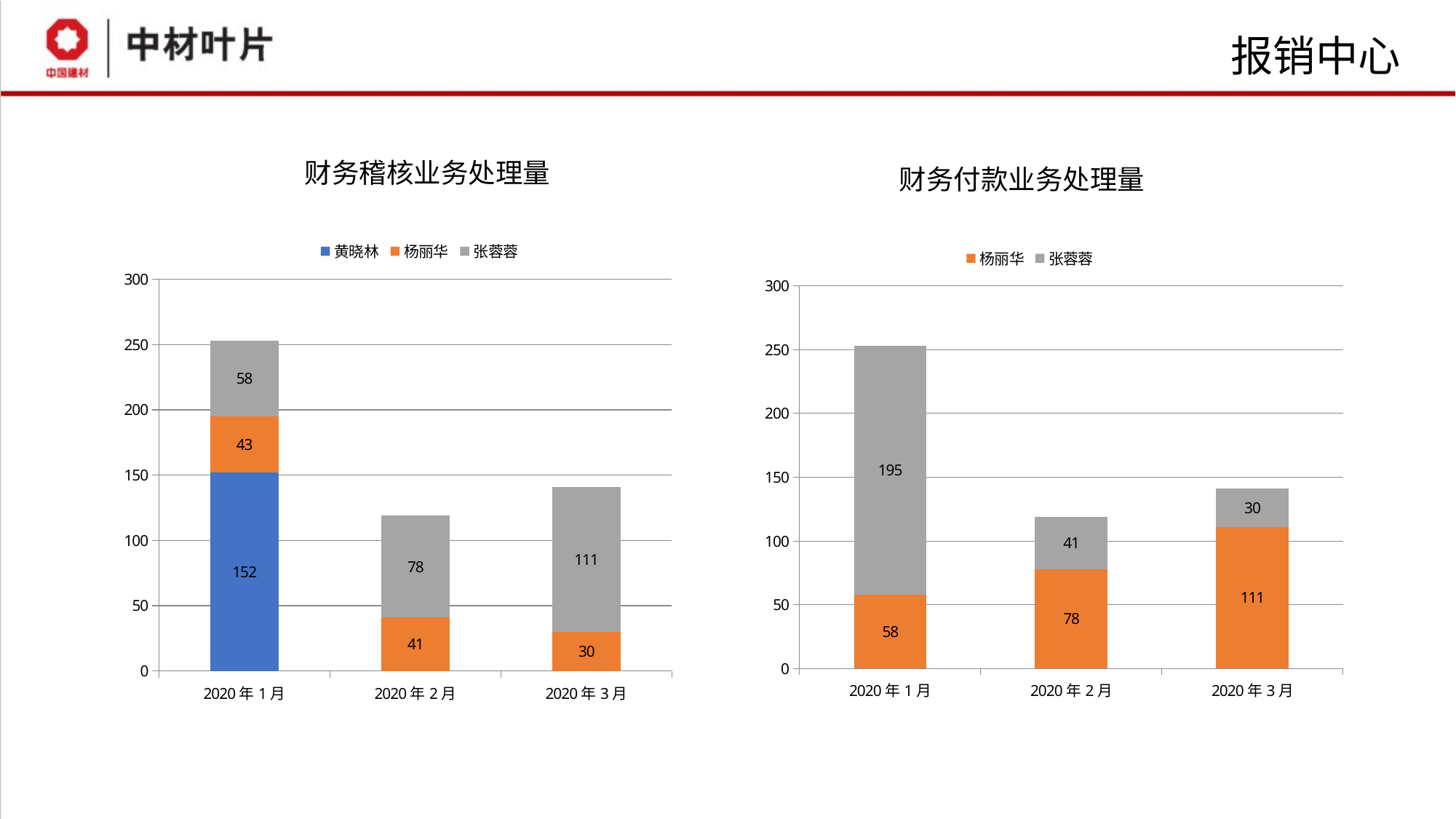
In the 财务付款业务处理量 chart, what is the value for 张蓉蓉 in 2020年1月? 195 In the 财务稽核业务处理量 chart, what is the value for 黄晓林 in 2020年1月? 152 In the 财务稽核业务处理量 chart, which month has the lowest total bar? 2020年2月 In the 财务付款业务处理量 chart, is the value for 杨丽华 in 2020年3月 larger or smaller than the value for 张蓉蓉 in the same month? larger In the 财务稽核业务处理量 chart, what is the value for 张蓉蓉 in 2020年3月? 111 In the 财务稽核业务处理量 chart, what is the total of the stacked bar for 2020年1月? 253 In the 财务付款业务处理量 chart, what is the value for 杨丽华 in 2020年2月? 78 What kind of chart is the 财务付款业务处理量 chart? stacked bar chart In the 财务付款业务处理量 chart, which month has the highest total bar? 2020年1月 How many series does the legend of the 财务稽核业务处理量 chart list? 3 In the 财务稽核业务处理量 chart, what is the difference between 张蓉蓉's values in 2020年3月 and 2020年2月? 33 In the 财务付款业务处理量 chart, what is the total of the stacked bar for 2020年3月? 141